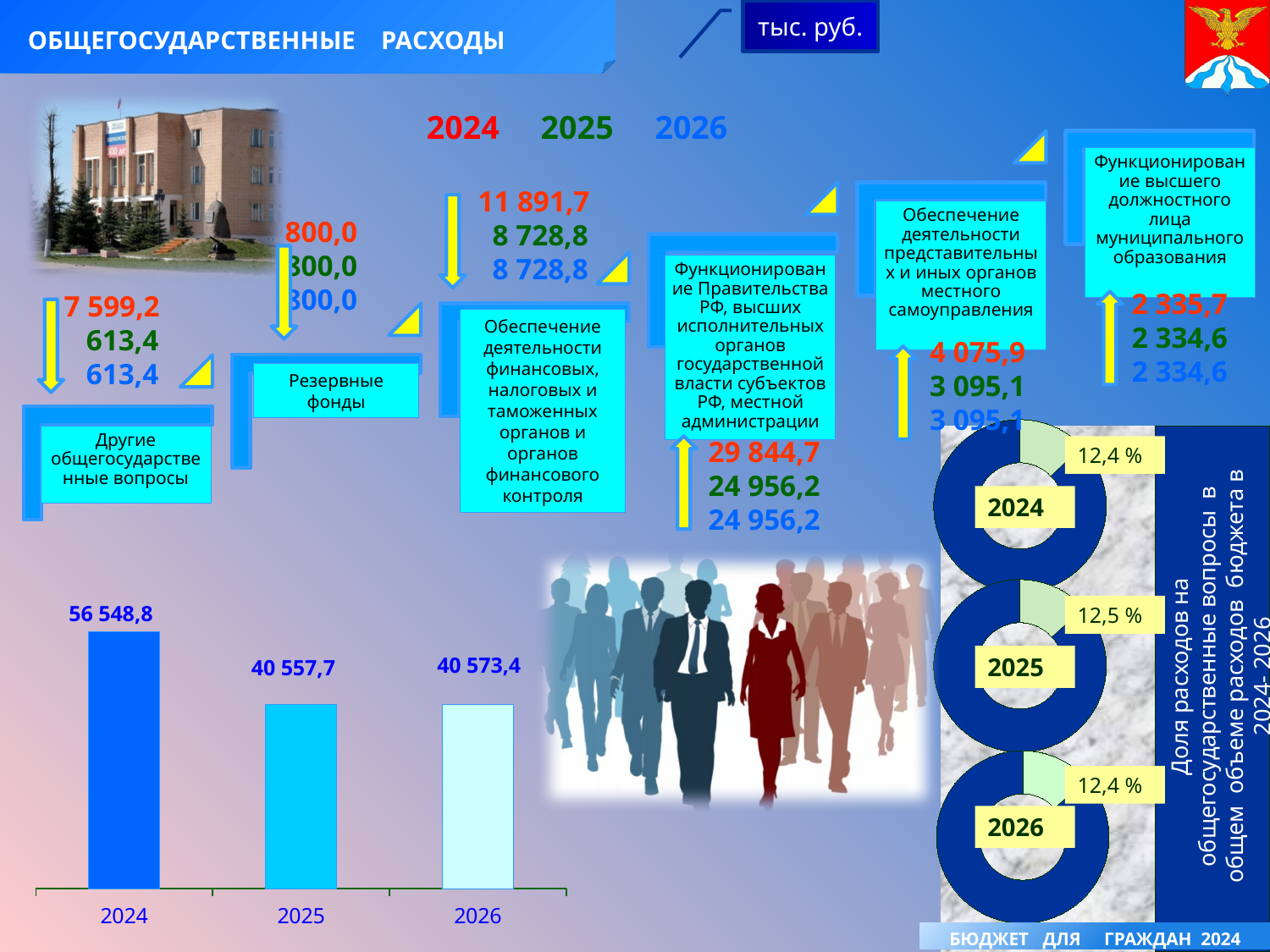
How many bars are in the bar chart at the bottom left? 3 In the bar chart at the bottom left, what is the difference between the values for 2024 and 2025? 15 991,1 In the bar chart at the bottom left, does the value rise or fall from 2024 to 2025? fall In the bar chart at the bottom left, which year has the lowest value? 2025 In the bar chart at the bottom left, what is the value for 2024? 56 548,8 In the bar chart at the bottom left, what is the value for 2026? 40 573,4 In the donut charts on the right, what share is shown for 2026? 12,4 % In the bar chart at the bottom left, what is the value for 2025? 40 557,7 In the bar chart at the bottom left, which year has the highest value? 2024 In the bar chart at the bottom left, which is larger, the value for 2025 or the value for 2026? 2026 In the donut charts on the right, what share is shown for 2025? 12,5 % What type of chart is shown at the bottom left of the slide? bar chart